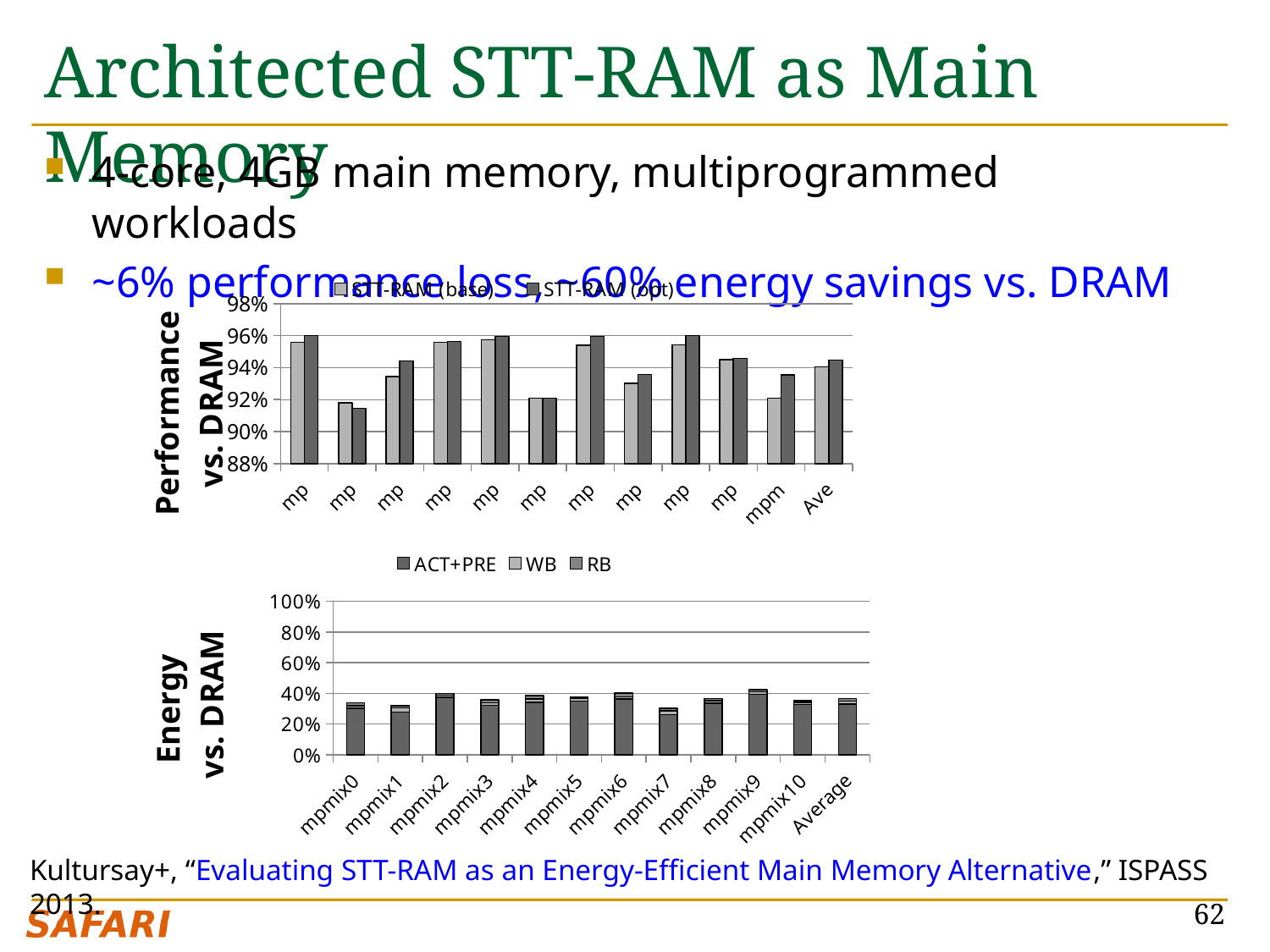
How many categories are shown on the x axis of the 'Energy vs. DRAM' chart? 12 How many series does the legend of the 'Performance vs. DRAM' chart at the top list? 2 In the 'Energy vs. DRAM' chart, which has the taller stacked bar, mpmix1 or mpmix6? mpmix6 In the 'Performance vs. DRAM' chart, is the STT-RAM (opt) value for mpm greater or less than 92%? greater In the 'Energy vs. DRAM' chart, is the total stacked value for mpmix7 greater or less than 40%? less In the 'Performance vs. DRAM' chart, is the STT-RAM (opt) value for Ave greater or less than 94%? greater In the 'Energy vs. DRAM' chart, which workload has the tallest stacked bar? mpmix9 How many series does the legend of the 'Energy vs. DRAM' chart list? 3 What are the legend entries of the 'Energy vs. DRAM' chart? ACT+PRE, WB, RB In the 'Energy vs. DRAM' chart, which has the taller stacked bar, mpmix9 or mpmix7? mpmix9 What kind of chart is the 'Energy vs. DRAM' chart at the bottom of the slide? bar chart